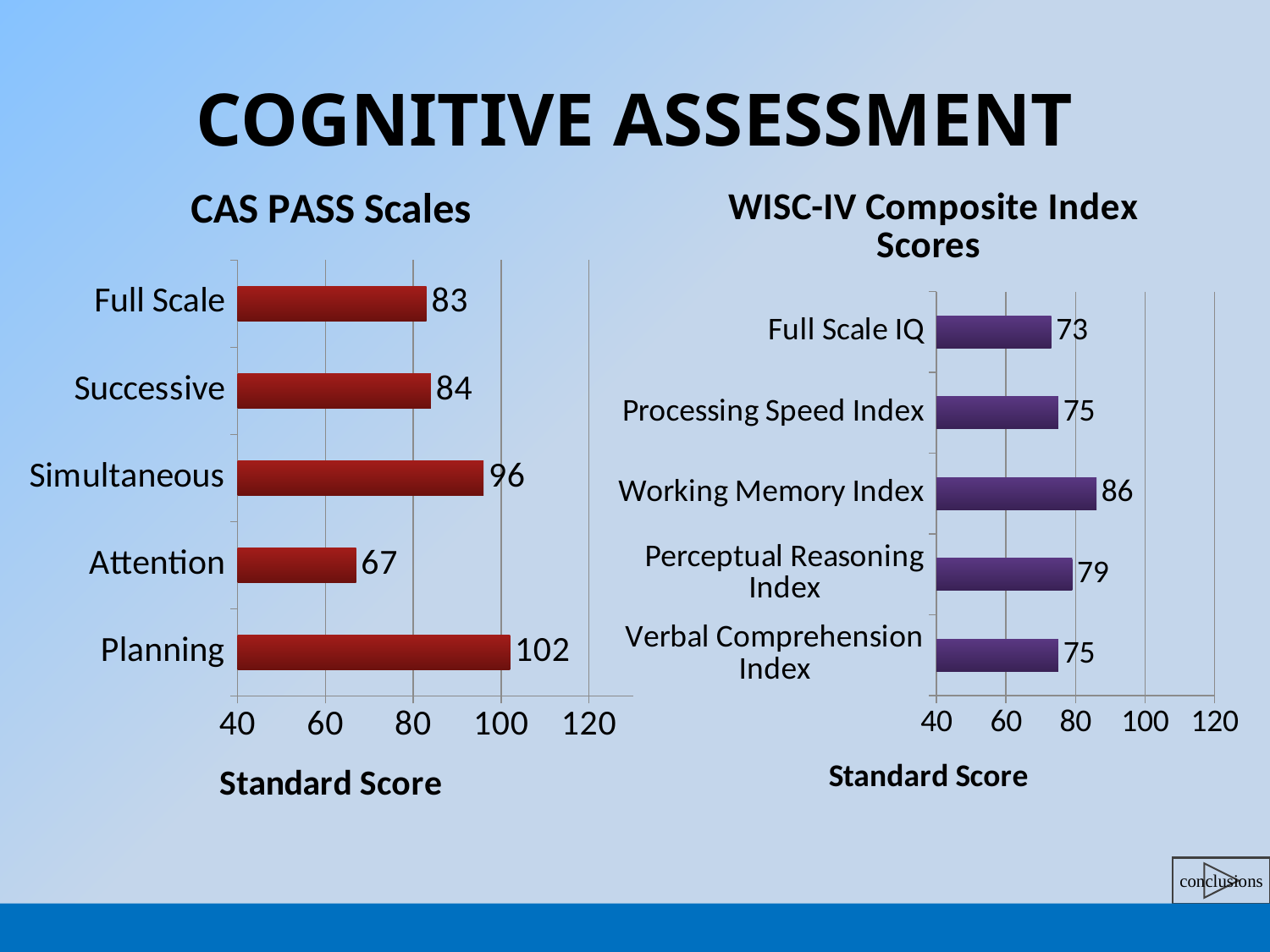
In the WISC-IV Composite Index Scores chart, which index has the highest score? Working Memory Index What type of chart is the CAS PASS Scales chart? Bar chart In the WISC-IV Composite Index Scores chart, what is the Working Memory Index score? 86 In the CAS PASS Scales chart, what is the difference between the Simultaneous and Successive scores? 12 In the CAS PASS Scales chart, what is the standard score for Attention? 67 In the CAS PASS Scales chart, how many scales are plotted? 5 In the WISC-IV Composite Index Scores chart, which is larger, the Perceptual Reasoning Index or the Processing Speed Index? Perceptual Reasoning Index In the WISC-IV Composite Index Scores chart, what is the difference between the Working Memory Index and the Full Scale IQ? 13 In the CAS PASS Scales chart, what is the standard score for Planning? 102 In the CAS PASS Scales chart, which scale has the lowest standard score? Attention In the WISC-IV Composite Index Scores chart, what is the Full Scale IQ score? 73 In the CAS PASS Scales chart, which scale has the highest standard score? Planning